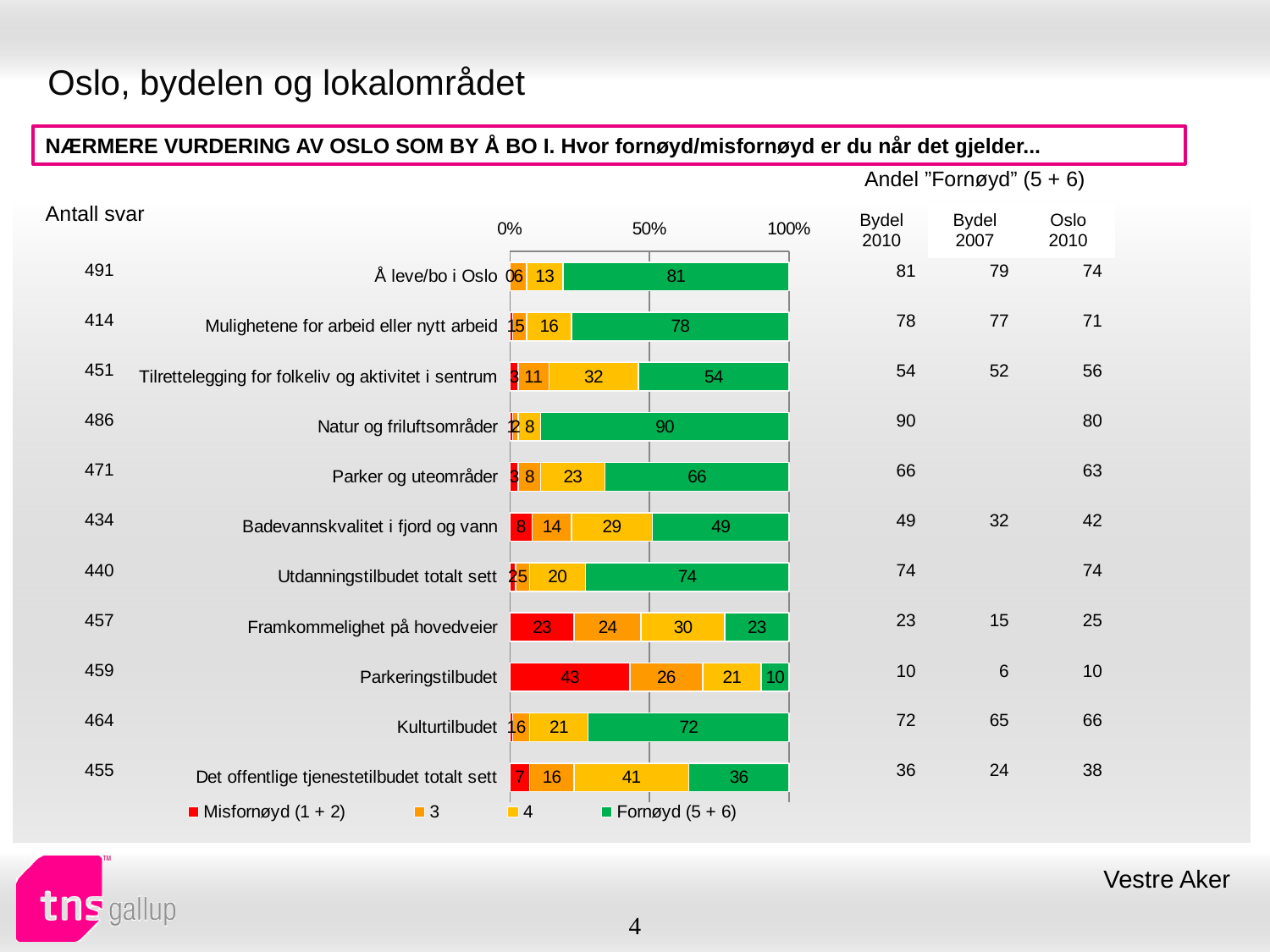
What kind of chart is shown on the slide? Stacked bar chart What is the Fornøyd (5 + 6) value for Natur og friluftsområder in the bar chart? 90 What is the Misfornøyd (1 + 2) value for Framkommelighet på hovedveier? 23 What is the Misfornøyd (1 + 2) value for Parkeringstilbudet? 43 How many categories (rows) does the bar chart show? 11 Which category has the highest Fornøyd (5 + 6) value in the bar chart? Natur og friluftsområder How many series does the chart legend list? 4 Which category has the lowest Fornøyd (5 + 6) value in the bar chart? Parkeringstilbudet What is the difference between the Fornøyd (5 + 6) values for Å leve/bo i Oslo and Kulturtilbudet? 9 Which has the larger Fornøyd (5 + 6) value: Parker og uteområder or Badevannskvalitet i fjord og vann? Parker og uteområder What is the value of the '4' segment for Det offentlige tjenestetilbudet totalt sett? 41 What is the first entry in the chart legend? Misfornøyd (1 + 2)